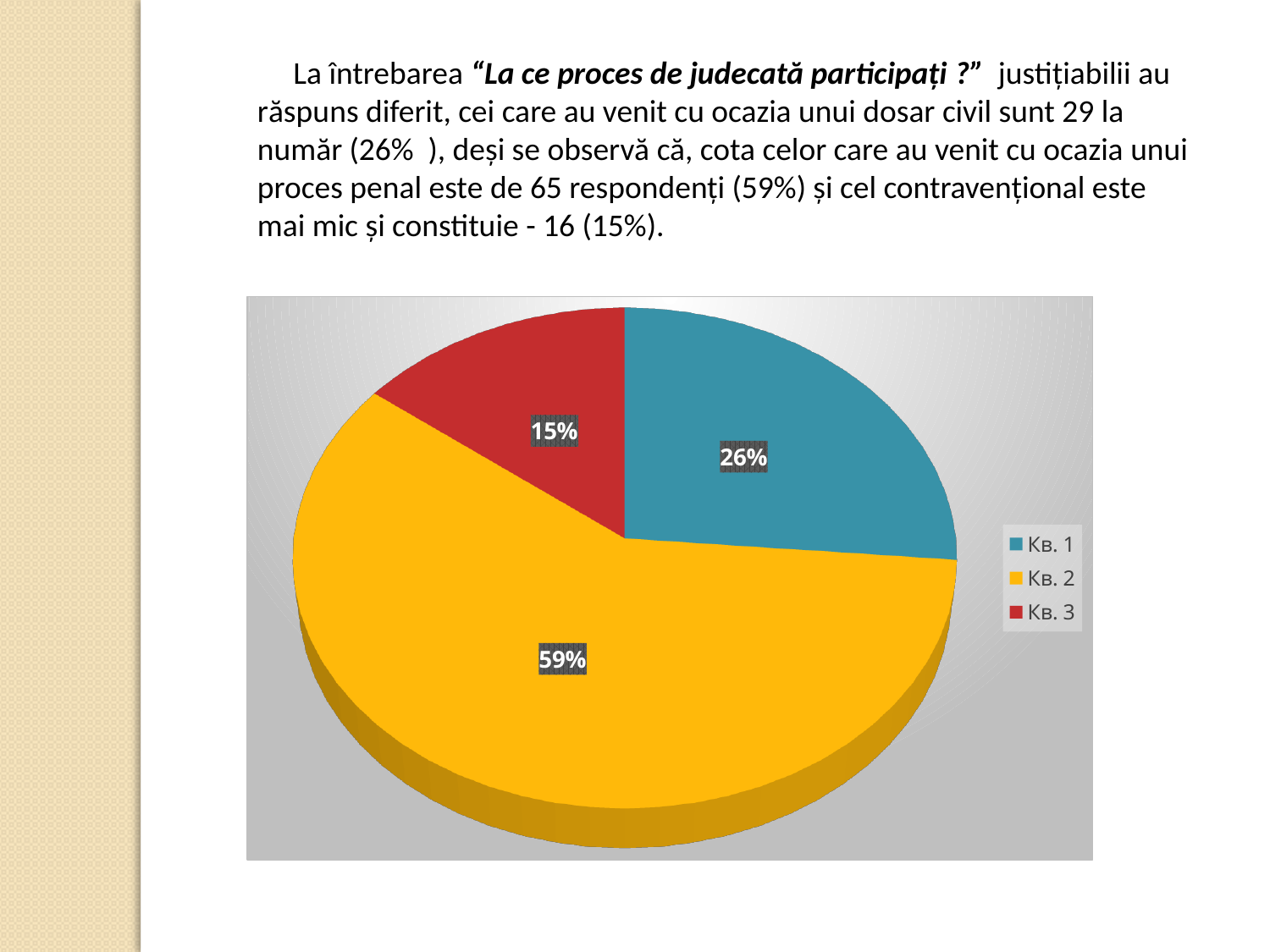
Which slice is larger in the pie chart, Кв. 1 or Кв. 3? Кв. 1 What percentage is shown for the slice labelled Кв. 3 in the pie chart? 15% What kind of chart is shown on the slide? pie chart What colour is the Кв. 2 slice in the pie chart? yellow What percentage is shown for the slice labelled Кв. 2 in the pie chart? 59% How many entries does the legend of the pie chart list? 3 How many slices does the pie chart have? 3 What percentage is shown for the slice labelled Кв. 1 in the pie chart? 26% Which slice of the pie chart is the largest? Кв. 2 Which slice of the pie chart is the smallest? Кв. 3 What is the difference in percentage points between the Кв. 2 slice and the Кв. 1 slice? 33 What colour is the Кв. 3 slice in the pie chart? red